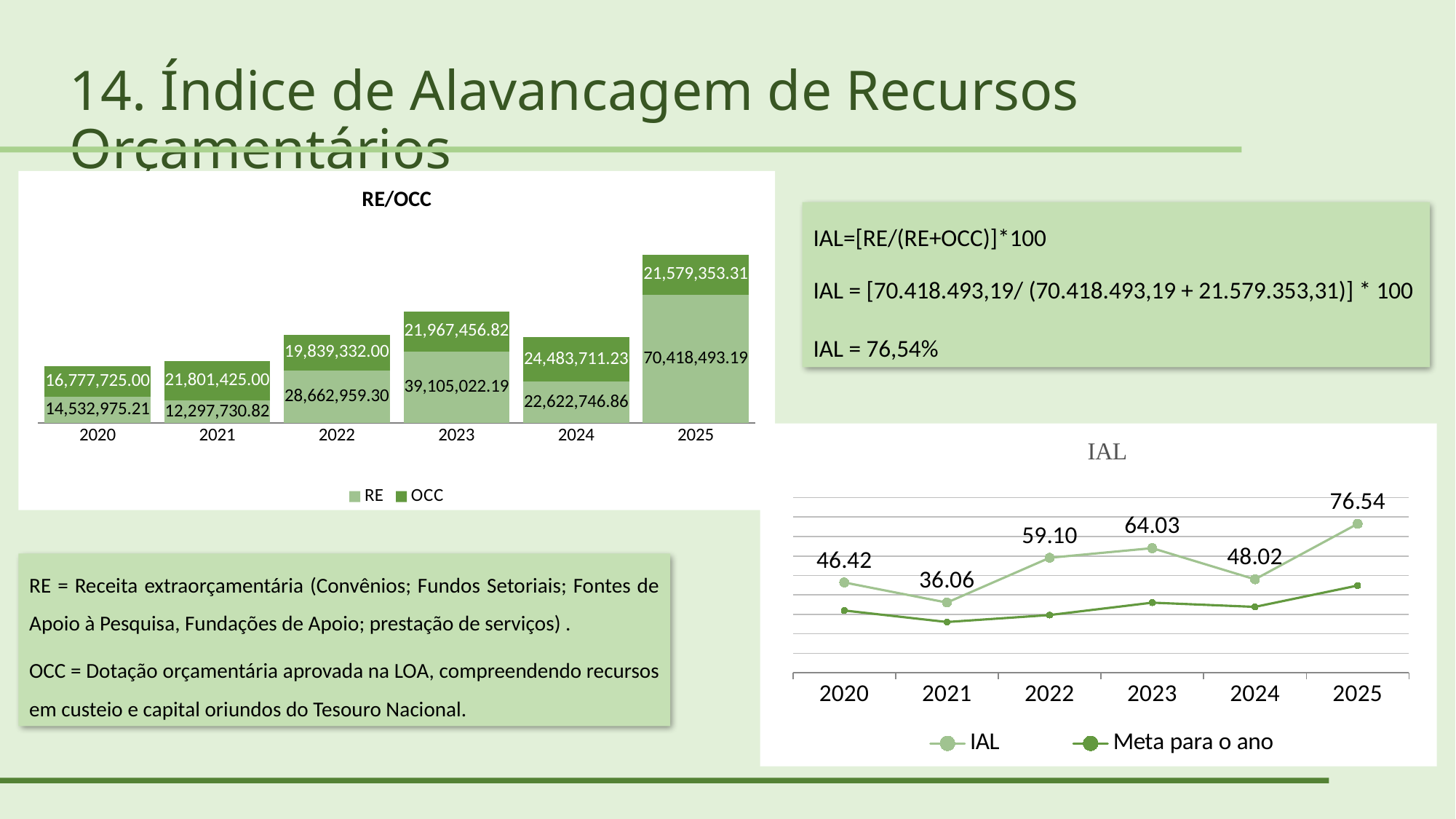
In the IAL chart, what is the difference between the IAL values for 2025 and 2024? 28.52 In the IAL chart, is the IAL value for 2022 larger than the IAL value for 2020? Yes In the RE/OCC chart, what is the total of the stacked bar for 2025? 91,997,846.50 What kind of chart is the RE/OCC chart? Stacked bar chart In the IAL chart, what is the IAL value for 2023? 64.03 In the RE/OCC chart, what is the RE value for 2025? 70,418,493.19 In the RE/OCC chart, which year has the lowest RE value? 2021 In the RE/OCC chart, what is the OCC value for 2021? 21,801,425.00 In the RE/OCC chart, how many series does the legend list? 2 In the IAL chart, how many years are plotted on the x axis? 6 In the RE/OCC chart, which year has the highest RE value? 2025 In the IAL chart, which year has the lowest IAL value? 2021